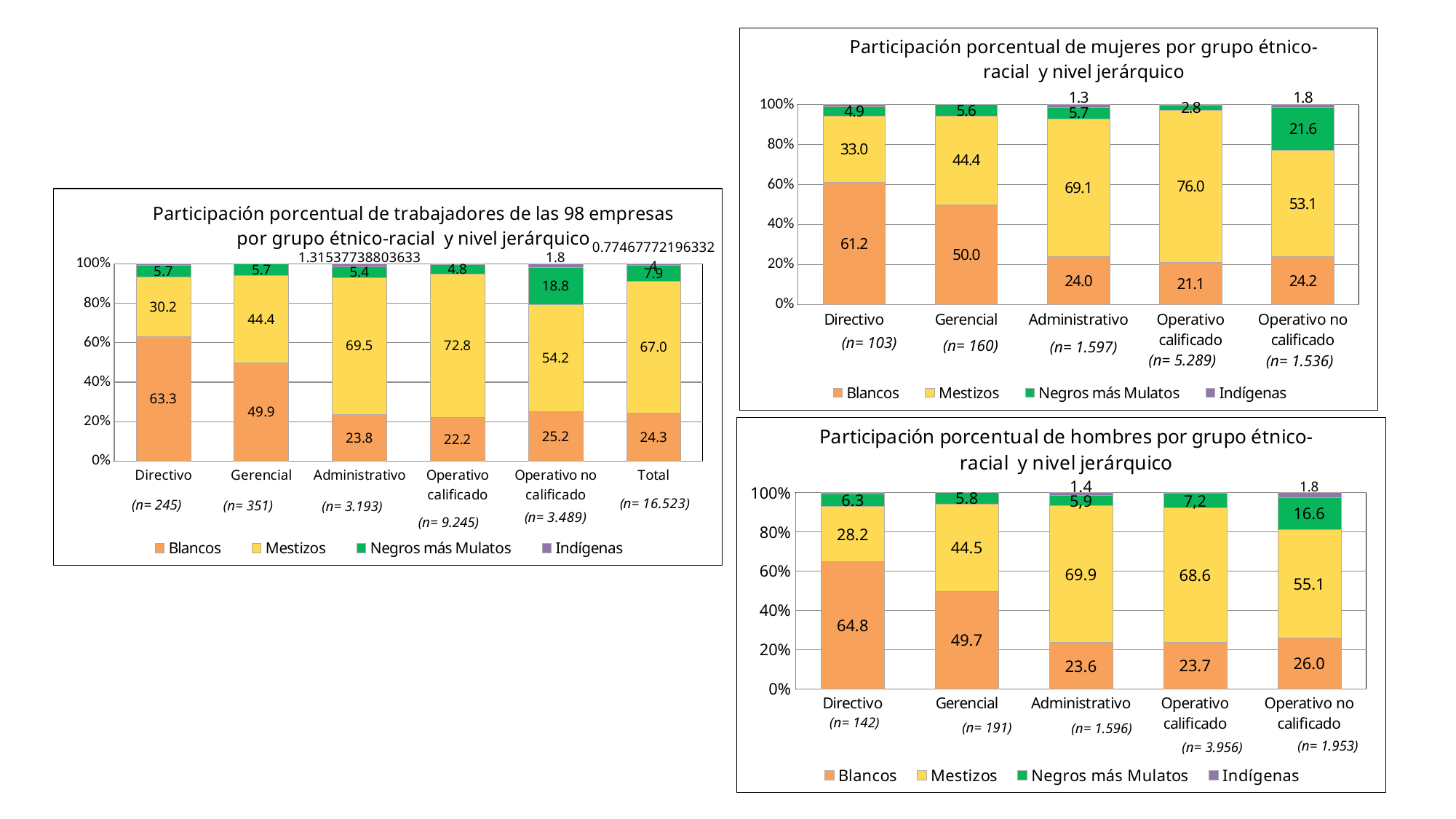
In the chart 'Participación porcentual de mujeres', what is the difference between the Blancos values for Directivo and Gerencial? 11.2 In the chart 'Participación porcentual de hombres', which is larger, the Mestizos value for Administrativo or for Operativo calificado? Administrativo In the chart 'Participación porcentual de trabajadores de las 98 empresas', how many categories are shown on the x axis? 6 In the chart 'Participación porcentual de hombres', what is the Blancos value for Directivo? 64.8 In the chart 'Participación porcentual de mujeres', which category has the lowest Blancos value? Operativo calificado In the chart 'Participación porcentual de hombres', what is the Negros más Mulatos value for Operativo no calificado? 16.6 What kind of chart is 'Participación porcentual de mujeres por grupo étnico-racial y nivel jerárquico'? Stacked bar chart In the chart 'Participación porcentual de trabajadores de las 98 empresas', what is the Mestizos value for Total? 67.0 In the chart 'Participación porcentual de mujeres', what is the Mestizos value for Operativo calificado? 76.0 In the chart 'Participación porcentual de trabajadores de las 98 empresas', which category has the highest Negros más Mulatos value? Operativo no calificado How many series does the legend of the chart 'Participación porcentual de hombres' list? 4 In the chart 'Participación porcentual de trabajadores de las 98 empresas', what is the Blancos value for Directivo? 63.3